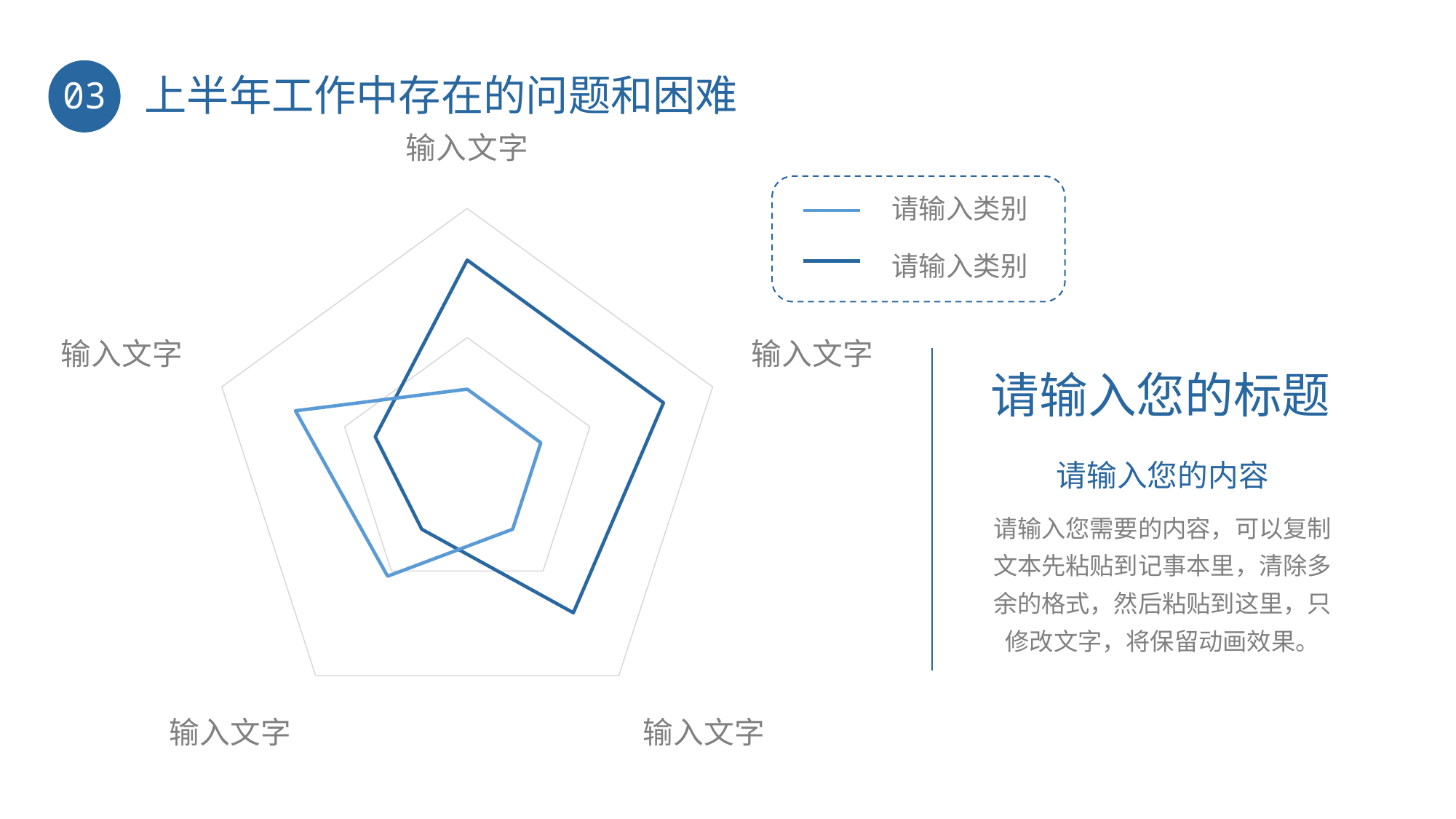
On the top axis of the radar chart, which series extends further from the centre, the light blue or the dark blue one? Dark blue What text is shown for the legend entries? 请输入类别 How many axes (categories) does the radar chart have? 5 On the right axis of the radar chart, which series extends further from the centre, the light blue or the dark blue one? Dark blue What label is shown on each axis of the radar chart? 输入文字 On the left axis of the radar chart, which series extends further from the centre, the light blue or the dark blue one? Light blue How many series does the legend list? 2 What kind of chart is shown on the slide? Radar chart